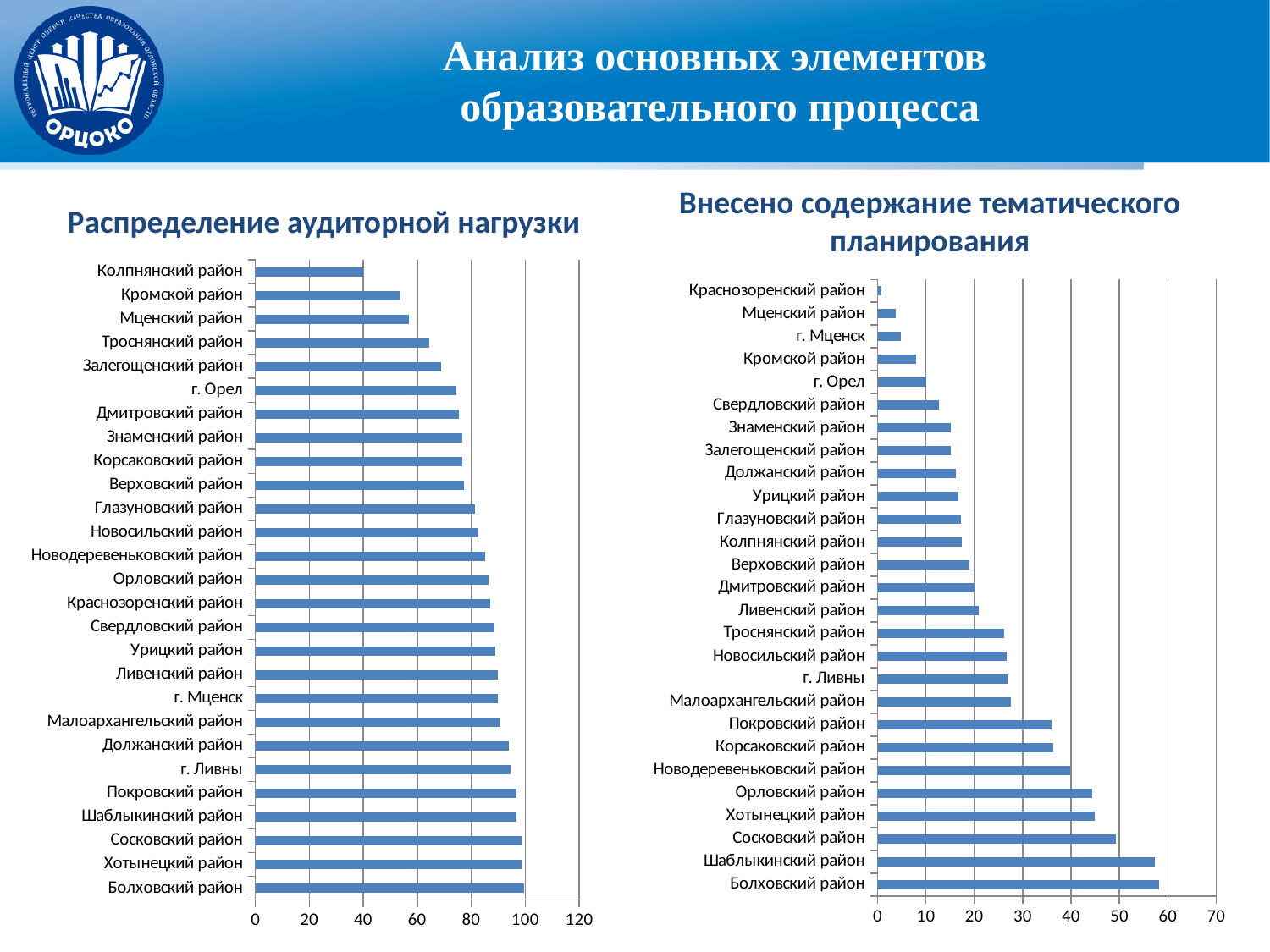
What is the title of the right chart on the slide? Внесено содержание тематического планирования In the left chart, 'Распределение аудиторной нагрузки', is the value for Троснянский район greater or less than 60? greater How many categories are shown in the right chart, 'Внесено содержание тематического планирования'? 27 In the right chart, 'Внесено содержание тематического планирования', which is larger: the value for Покровский район or for Кромской район? Покровский район In the left chart, 'Распределение аудиторной нагрузки', is the value for Кромской район greater or less than 60? less In the right chart, 'Внесено содержание тематического планирования', is the value for Покровский район greater or less than 30? greater How many categories are shown in the left chart, 'Распределение аудиторной нагрузки'? 27 In the right chart, 'Внесено содержание тематического планирования', which category has the lowest value? Краснозоренский район What kind of chart is the left chart, 'Распределение аудиторной нагрузки'? bar chart In the left chart, 'Распределение аудиторной нагрузки', which is larger: the value for Залегощенский район or for Колпнянский район? Залегощенский район In the left chart, 'Распределение аудиторной нагрузки', which category has the lowest value? Колпнянский район